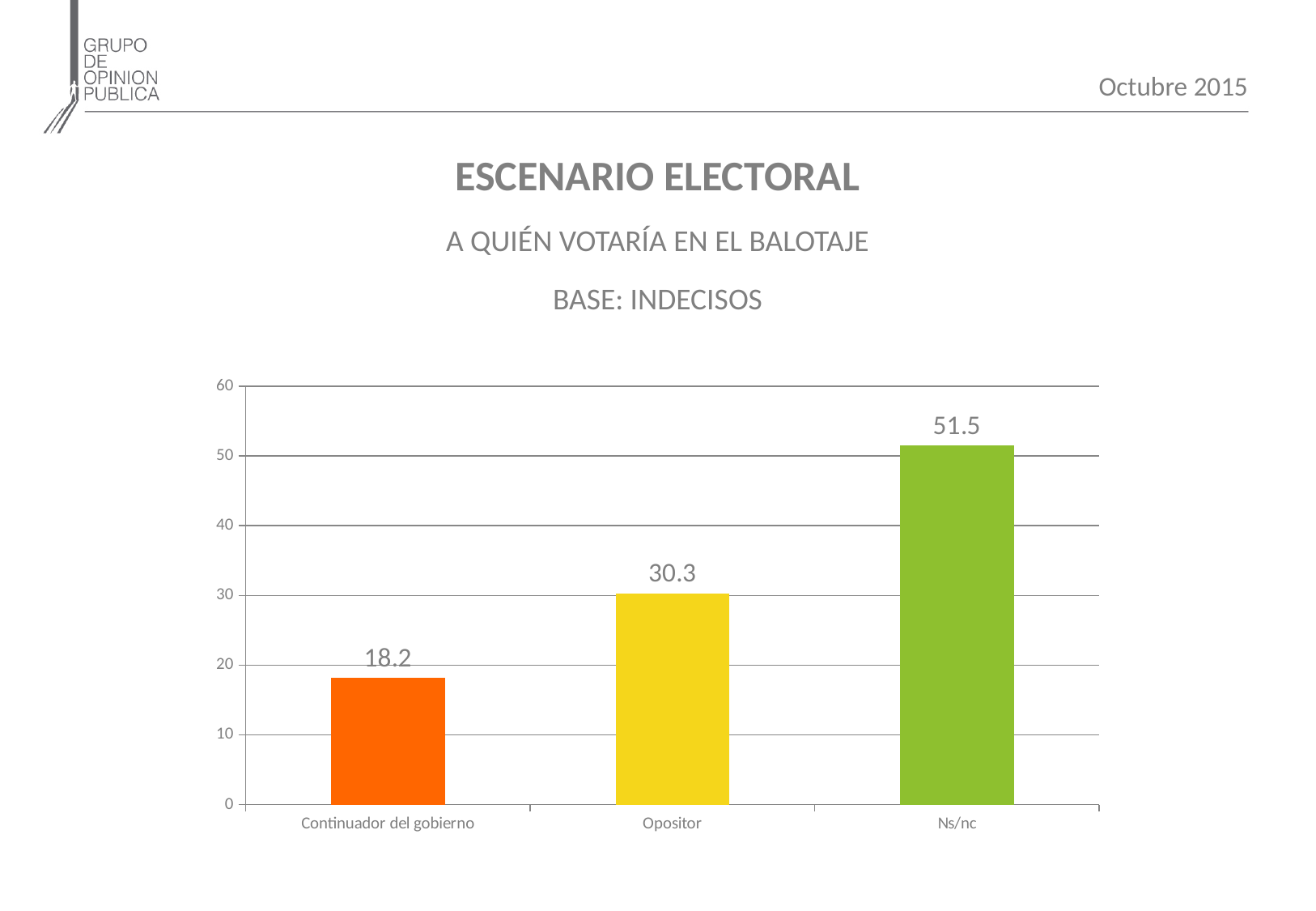
How many categories are shown in the chart? 3 What colour is the bar for Opositor? Yellow Which category has the highest value? Ns/nc What is the difference between the values for Ns/nc and Opositor? 21.2 What is the value for Opositor? 30.3 What is the value for Continuador del gobierno? 18.2 Which category has the lowest value? Continuador del gobierno Is the value for Ns/nc greater or less than 50? greater What is the difference between the values for Opositor and Continuador del gobierno? 12.1 Which is larger, the value for Opositor or the value for Continuador del gobierno? Opositor What kind of chart is shown on the slide? Bar chart What is the value for Ns/nc? 51.5